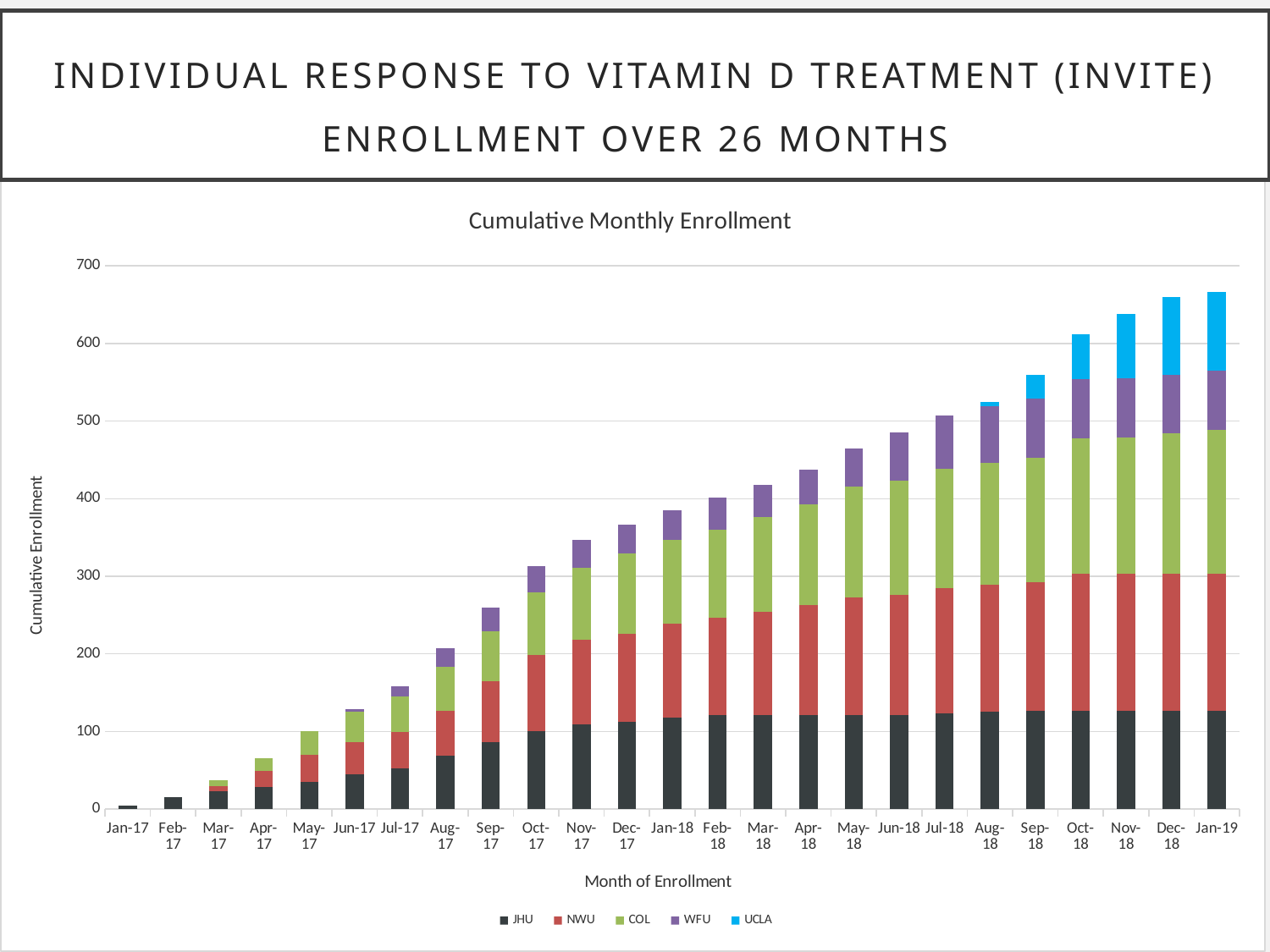
What kind of chart is shown on the slide? Stacked bar chart What is the title of the chart? Cumulative Monthly Enrollment Which series are listed in the legend? JHU, NWU, COL, WFU, UCLA Is the total cumulative enrollment for Apr-17 greater or less than 100? less Which month has the larger total cumulative enrollment, Jun-18 or Sep-18? Sep-18 Is the total cumulative enrollment for Jan-19 greater or less than 600? greater How many months (bars) are plotted on the x axis? 25 Which month has the highest total cumulative enrollment? Jan-19 Do the total bar heights rise or fall from Jan-17 to Jan-19? Rise Which month has the lowest total cumulative enrollment? Jan-17 Is the total cumulative enrollment for Jan-18 greater or less than 400? less How many series does the legend list? 5